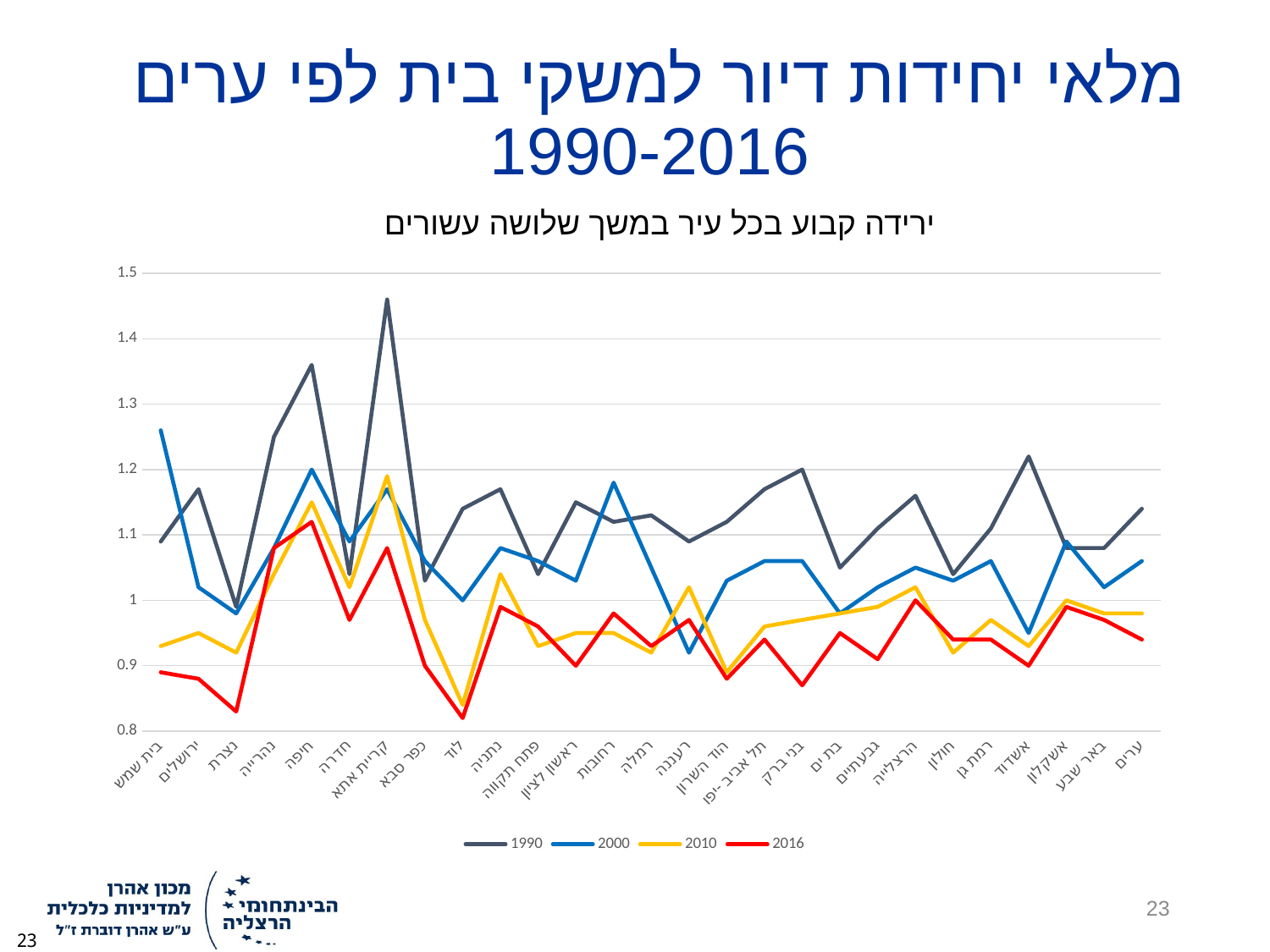
How many categories (cities) are shown along the x axis? 27 How many series does the legend list? 4 Is the 1990 value for קריית אתא greater or less than 1.4? greater For חיפה, which series has the larger value: 1990 or 2016? 1990 Which city has the lowest value in the 1990 series? נצרת Is the 2000 value for בית שמש greater or less than 1.2? greater What kind of chart is shown on the slide? line chart Is the 1990 value for חיפה greater or less than 1.3? greater For בית שמש, which series has the larger value: 1990 or 2000? 2000 Which city has the highest value in the 1990 series? קריית אתא Which years are listed in the legend? 1990, 2000, 2010, 2016